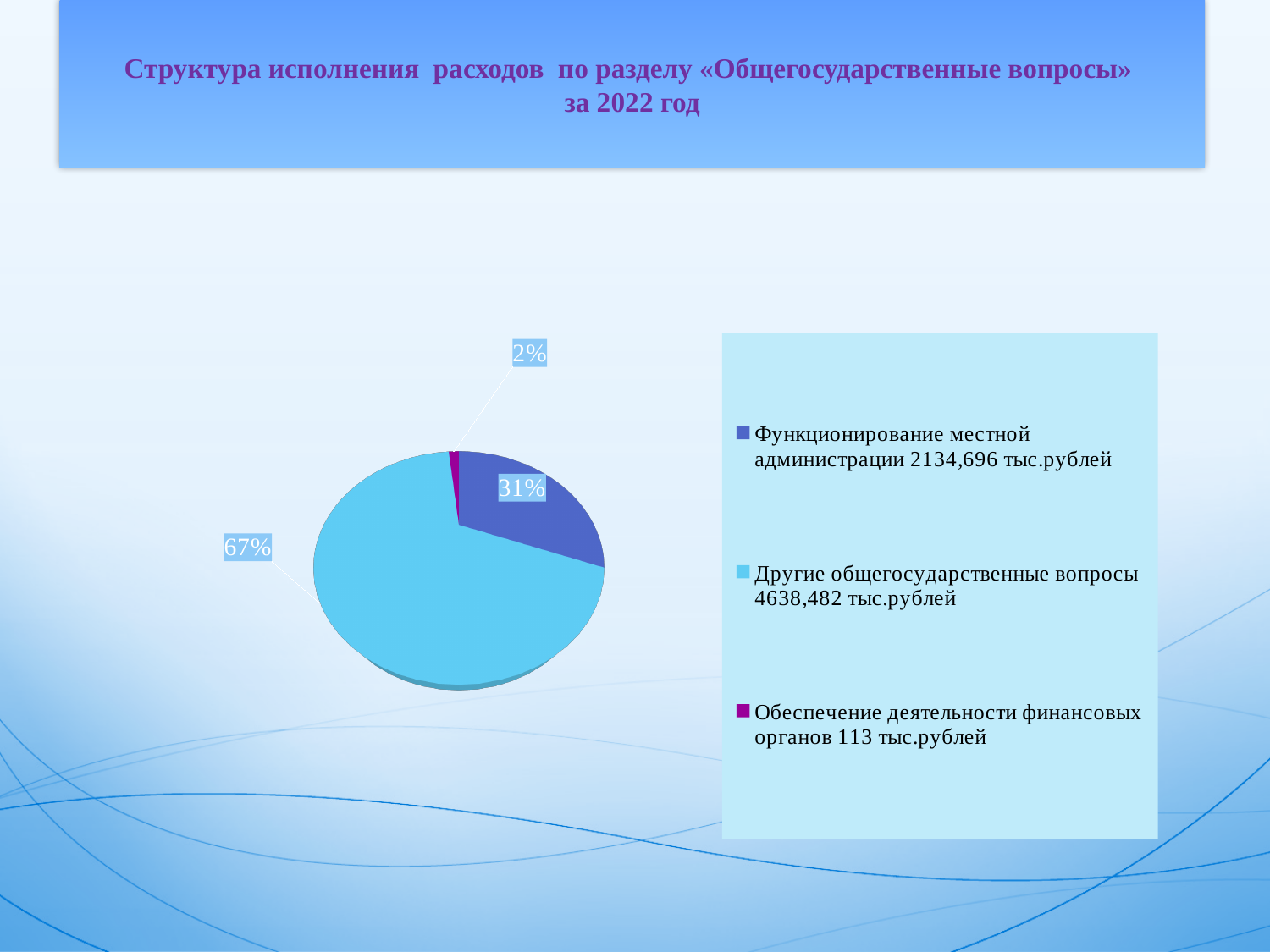
What is the difference in percentage points between the 67% slice and the 31% slice? 36 What share of the pie is labelled for «Функционирование местной администрации»? 31% What share of the pie is labelled for «Другие общегосударственные вопросы»? 67% What colour is the slice for «Обеспечение деятельности финансовых органов»? purple Which category has the smallest slice of the pie? Обеспечение деятельности финансовых органов What share of the pie is labelled for «Обеспечение деятельности финансовых органов»? 2% How many slices does the pie chart have? 3 What amount in тыс.рублей does the legend give for «Функционирование местной администрации»? 2134,696 тыс.рублей Which category has the largest slice of the pie? Другие общегосударственные вопросы Which is larger: the slice for «Функционирование местной администрации» or the slice for «Обеспечение деятельности финансовых органов»? Функционирование местной администрации How many entries does the legend list? 3 What kind of chart is shown on the slide? pie chart